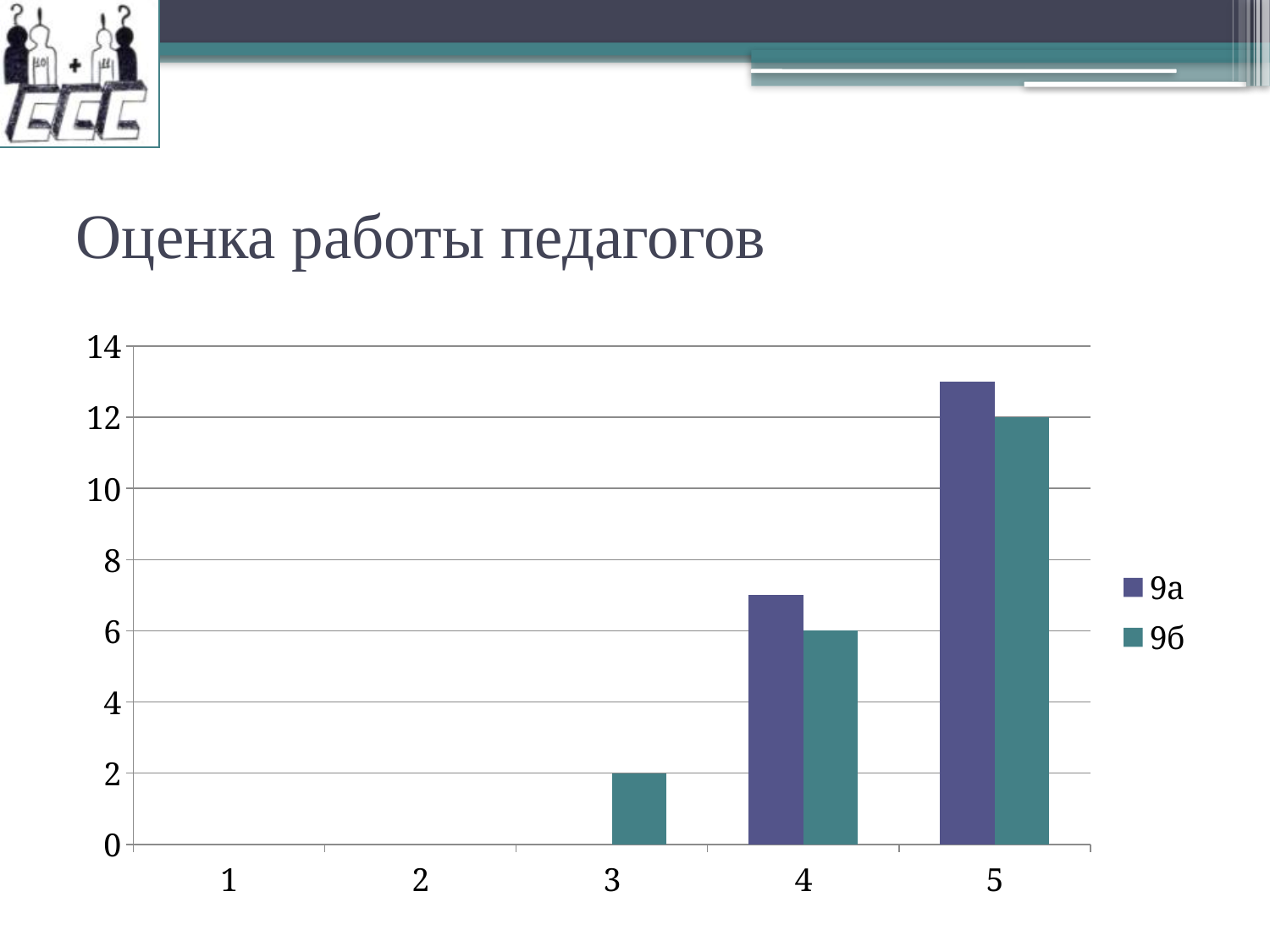
What is the value for series 9б at category 4? 6 What is the value for series 9б at category 3? 2 Which category has the highest value for series 9а? 5 How many series does the legend list? 2 Do the values for series 9б rise or fall from category 3 to category 5? rise At category 5, which series has the larger value, 9а or 9б? 9а What is the difference between the values for series 9б at category 5 and category 3? 10 What is the value for series 9б at category 5? 12 How many categories are shown on the x axis? 5 Is the value for series 9а at category 4 greater or less than 8? less What kind of chart is shown on the slide? bar chart Is the value for series 9а at category 5 greater or less than 12? greater